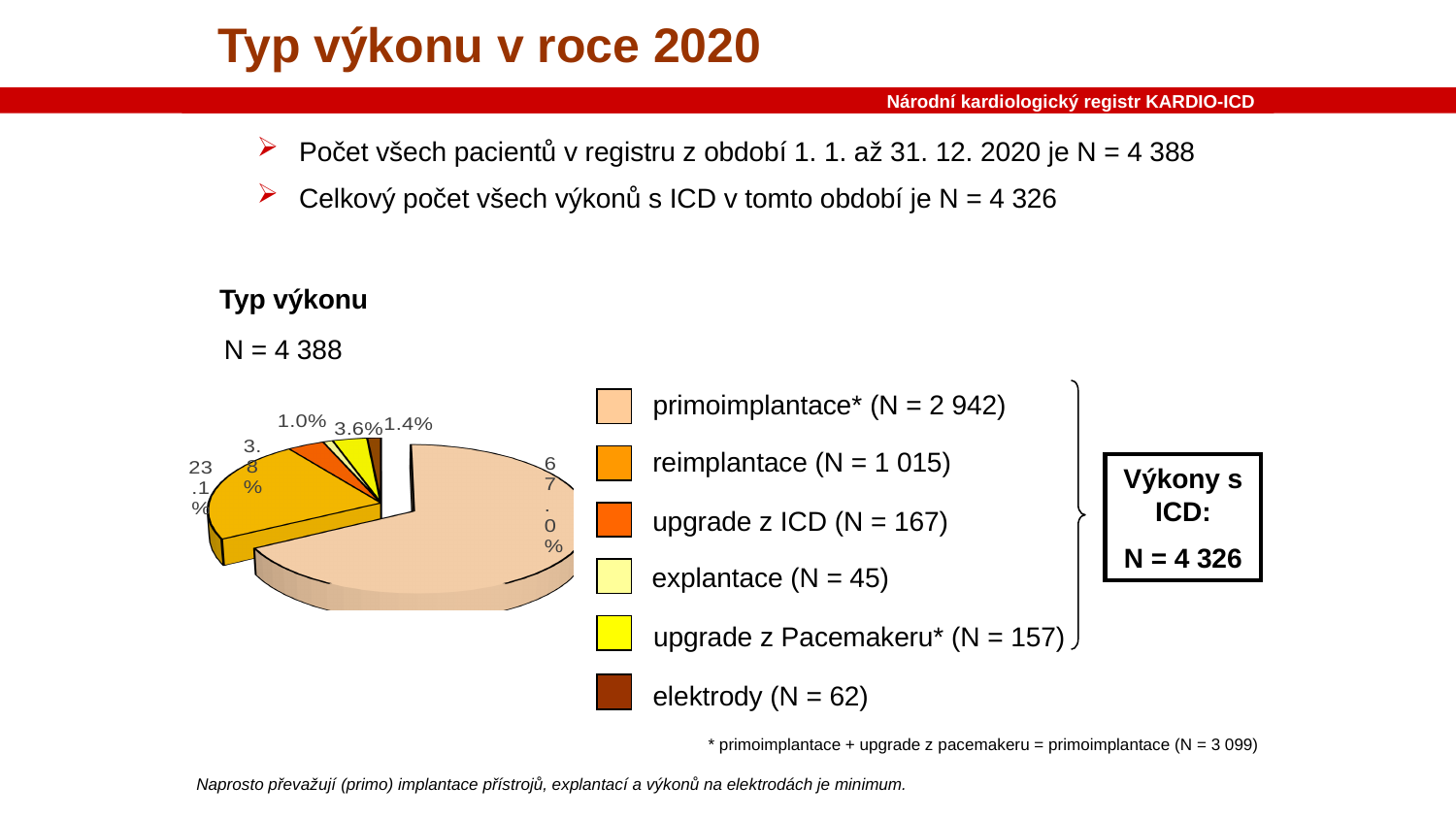
What is the N value for explantace? N = 45 How many categories does the pie chart's legend list? 6 What is the N value for elektrody? N = 62 What is the difference in N between primoimplantace* and reimplantace? 1 927 What kind of chart is shown on the slide? pie chart What is the N value for reimplantace? N = 1 015 What is the N value for primoimplantace* in the legend? N = 2 942 What percentage share of the pie does upgrade z Pacemakeru* have? 3.6% Which category has the smallest share of the pie? explantace Which category has the largest share of the pie? primoimplantace* What is the title of the pie chart? Typ výkonu Which is larger, upgrade z ICD or upgrade z Pacemakeru*? upgrade z ICD